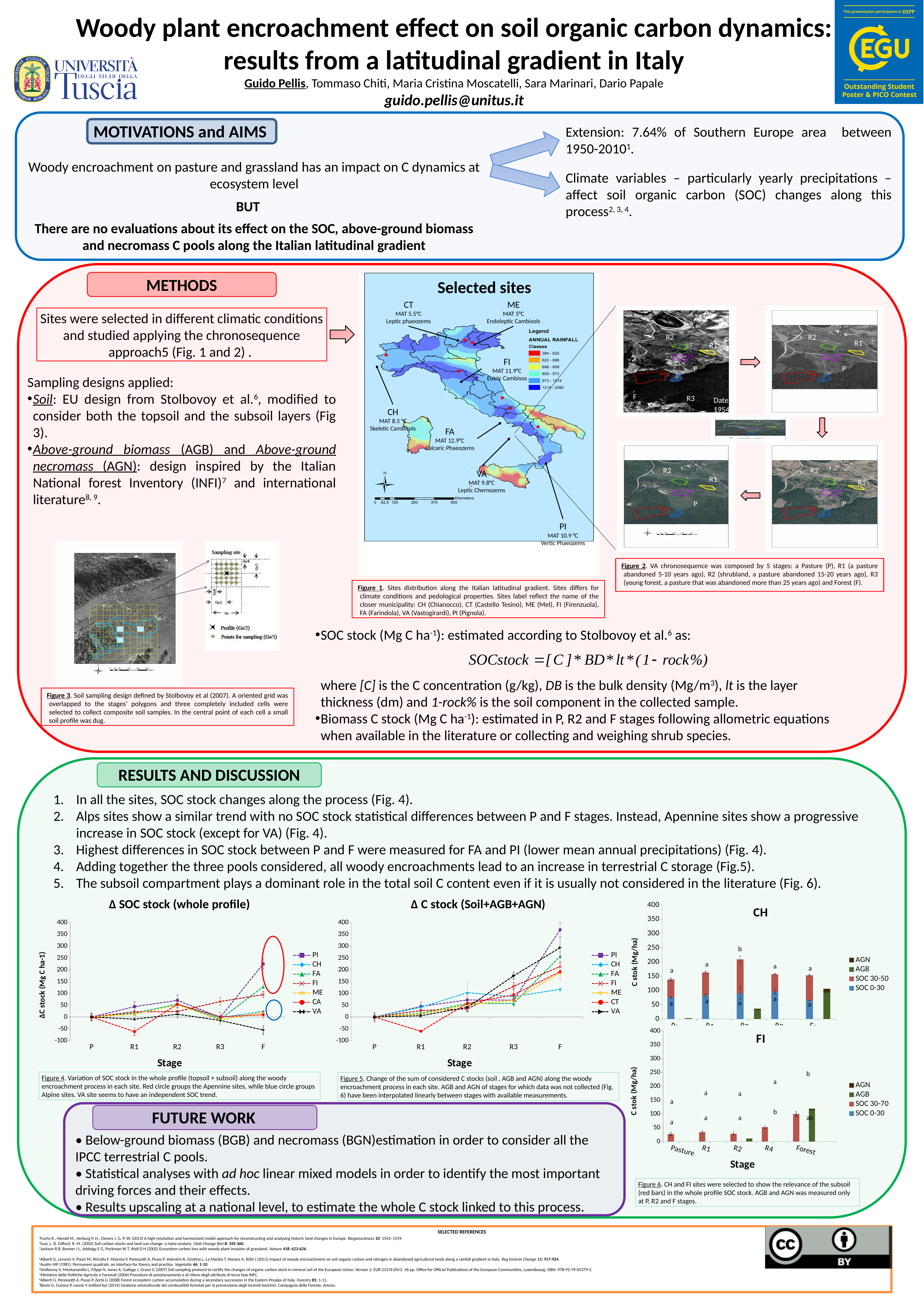
In the 'Δ C stock (Soil+AGB+AGN)' chart, which site has the lowest value at stage R1? CT In the 'Δ SOC stock (whole profile)' chart, which site has the lowest value at stage F? VA In the 'Δ C stock (Soil+AGB+AGN)' chart, does the PI series rise or fall from stage P to stage F? rise How many series does the legend of the 'FI' chart list? 4 What kind of chart is the 'Δ SOC stock (whole profile)' chart? line chart In the 'Δ SOC stock (whole profile)' chart, is the value for PI at stage F greater or less than 150? greater How many series does the legend of the 'Δ SOC stock (whole profile)' chart list? 7 What kind of chart is the 'CH' chart on the right of the results section? bar chart In the 'Δ C stock (Soil+AGB+AGN)' chart, is the value for PI at stage F greater or less than 300? greater How many stages are shown on the x axis of the 'Δ C stock (Soil+AGB+AGN)' chart? 5 In the 'FI' chart, is the soil C stock bar for Pasture greater or less than 50? less In the 'Δ SOC stock (whole profile)' chart, which site has the highest value at stage F? PI